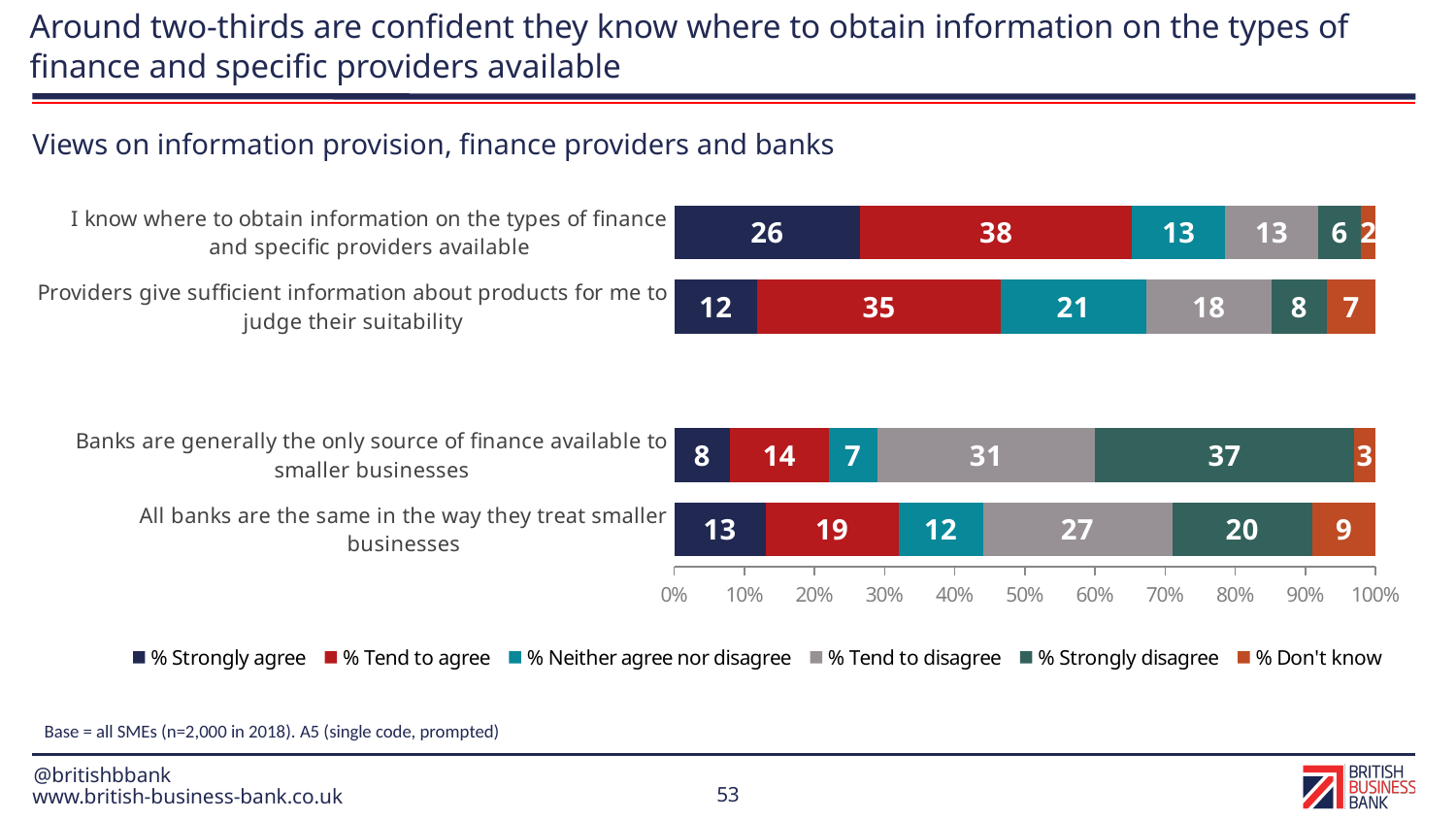
What is the title of the chart? Views on information provision, finance providers and banks What is the % Don't know value for 'All banks are the same in the way they treat smaller businesses'? 9 How many statements (categories) are plotted in the chart? 4 Which statement has the lowest % Tend to agree value? Banks are generally the only source of finance available to smaller businesses What is the difference between the % Tend to disagree values for 'Banks are generally the only source of finance available to smaller businesses' and 'All banks are the same in the way they treat smaller businesses'? 4 How many series does the legend list? 6 What type of chart is shown on the slide? Stacked bar chart What is the % Strongly disagree value for 'Banks are generally the only source of finance available to smaller businesses'? 37 Which is larger: the % Neither agree nor disagree value for 'Providers give sufficient information about products for me to judge their suitability' or for 'All banks are the same in the way they treat smaller businesses'? Providers give sufficient information about products for me to judge their suitability What is the % Strongly agree value for 'I know where to obtain information on the types of finance and specific providers available'? 26 Which statement has the highest % Strongly agree value? I know where to obtain information on the types of finance and specific providers available What is the % Tend to agree value for 'Providers give sufficient information about products for me to judge their suitability'? 35